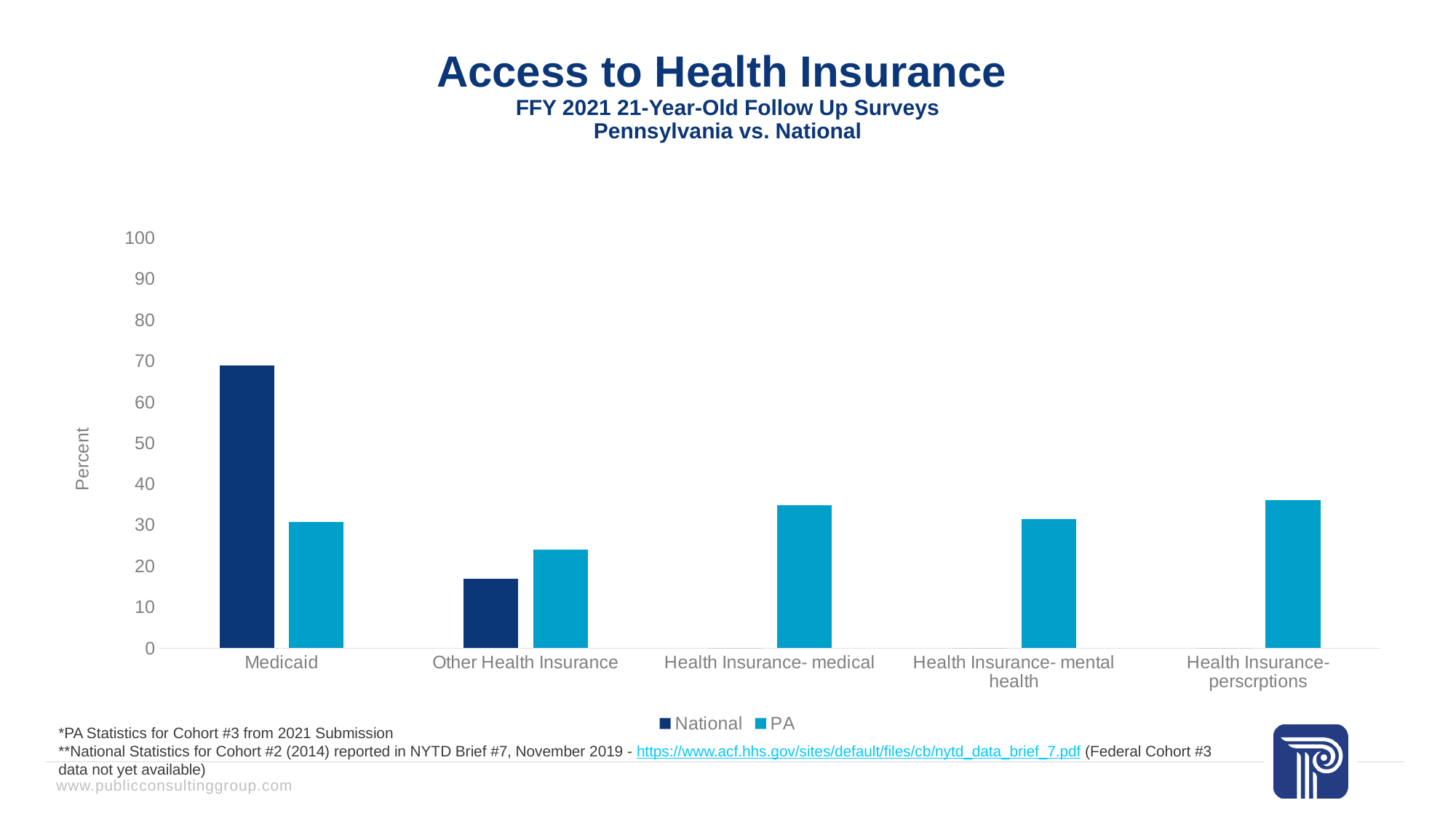
How many series does the legend list? 2 Which category has the lowest National value among those with a National bar? Other Health Insurance Is the PA value for Health Insurance- perscrptions greater or less than 30? greater Which category has the highest National value? Medicaid Is the National value for Other Health Insurance greater or less than 20? less What is the label on the vertical axis? Percent For Other Health Insurance, which is larger, the National value or the PA value? PA Is the PA value for Health Insurance- medical greater or less than 40? less How many categories are shown on the x axis? 5 What kind of chart is shown on the slide? bar chart For Medicaid, which is larger, the National value or the PA value? National